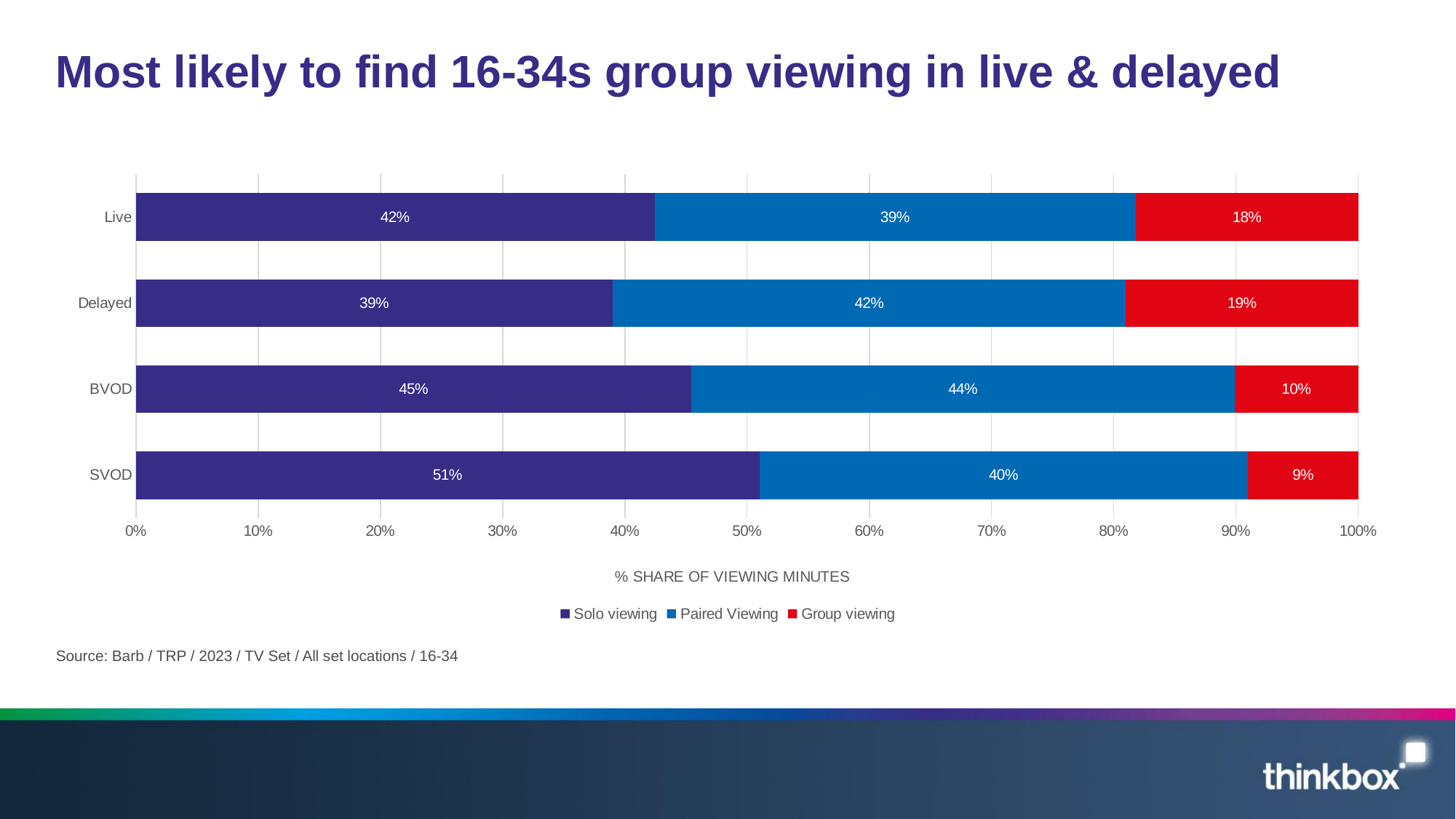
Which colour represents Group viewing in the chart? Red What kind of chart is shown on the slide? Stacked bar chart What is the difference between the Group viewing share for Live and for SVOD? 9% What is the x-axis label of the chart? % SHARE OF VIEWING MINUTES What is the Group viewing share for Delayed? 19% How many series does the legend list? 3 Which category has the highest Group viewing share? Delayed Which category has the lowest Solo viewing share? Delayed What is the Paired Viewing share for BVOD? 44% How many categories are shown on the y axis? 4 What is the Solo viewing share for SVOD? 51% Is the Solo viewing share larger for BVOD or for Live? BVOD